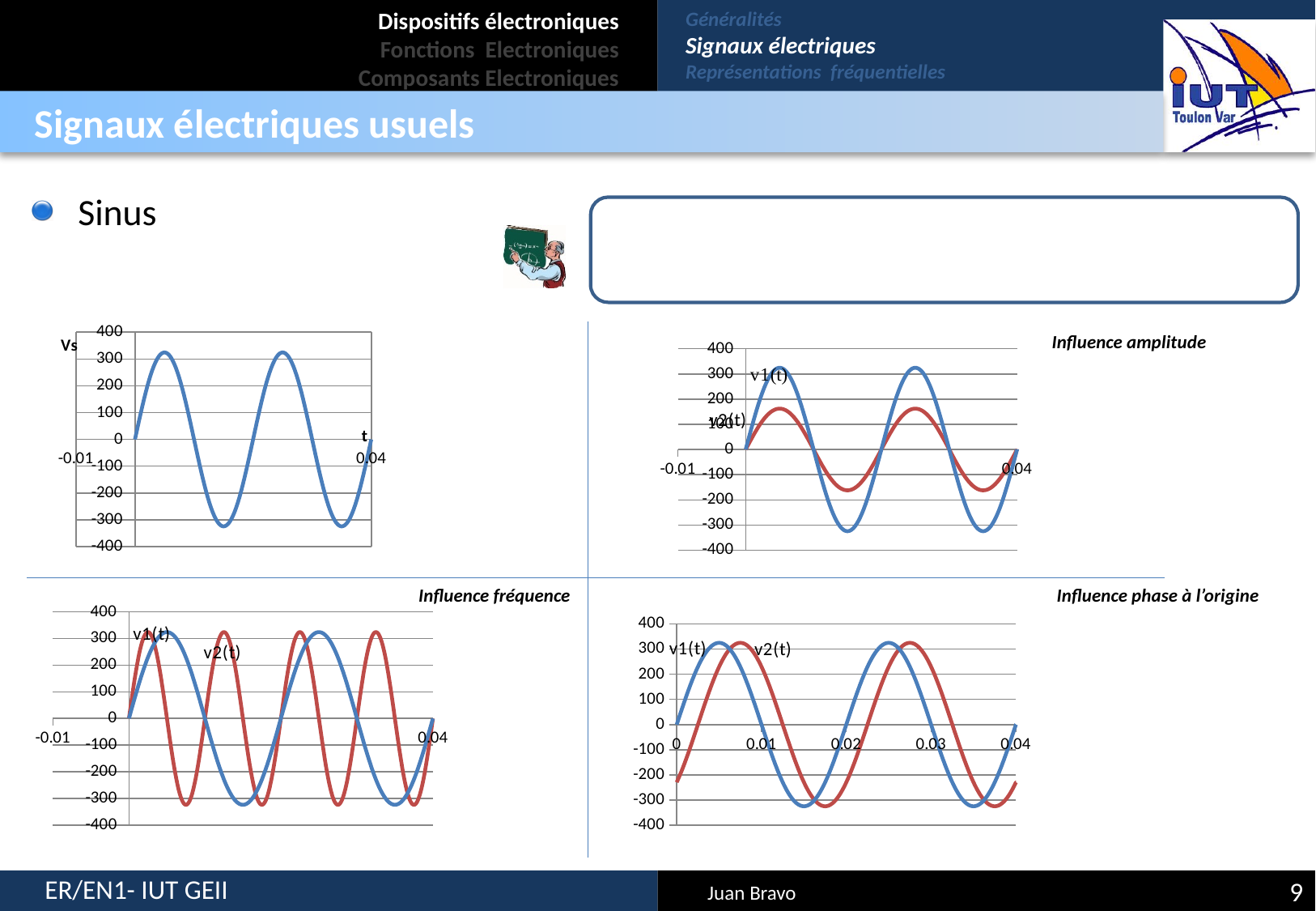
In the 'Influence amplitude' chart, which series has the larger peak value, v1(t) or v2(t)? v1(t) What is the title of the chart in the top-right of the slide? Influence amplitude In the top-left chart labelled Vs, is the minimum value of the curve greater or less than -300? less What is the title of the chart in the bottom-right of the slide? Influence phase à l'origine How many series are plotted in the 'Influence phase à l'origine' chart? 2 What kind of chart is the top-left chart labelled Vs? line chart In the top-left chart labelled Vs, is the peak value of the curve greater or less than 300? greater How many series are plotted in the 'Influence amplitude' chart? 2 In the 'Influence amplitude' chart, is the peak value of v2(t) greater or less than 200? less In the 'Influence fréquence' chart, which series has the higher frequency, v1(t) or v2(t)? v2(t) In the 'Influence fréquence' chart, how many positive peaks does v2(t) show between 0 and 0.04? 4